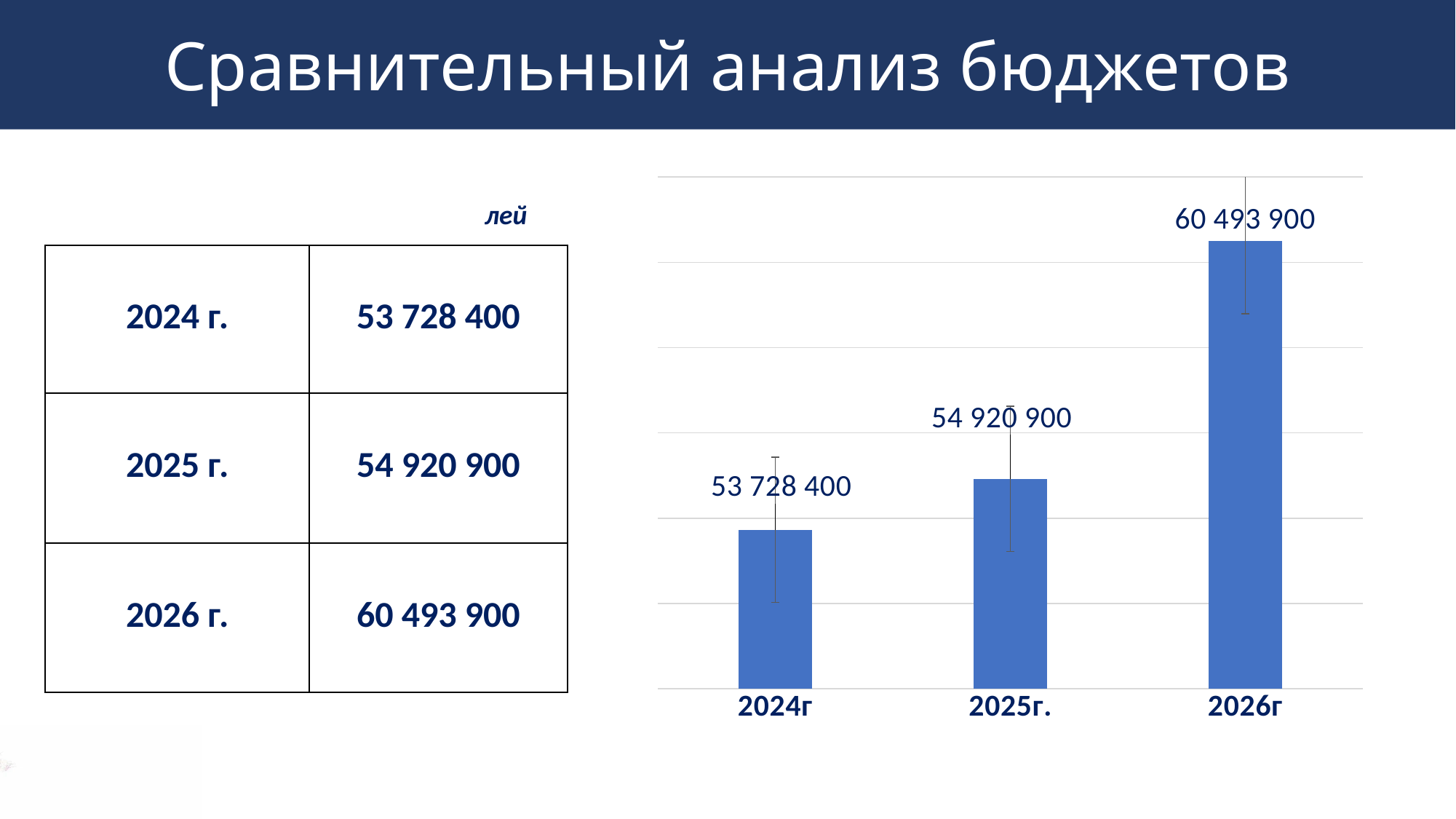
Which year has the lowest value in the bar chart? 2024г What is the difference between the values for 2026г and 2025г. in the bar chart? 5 573 000 What is the value shown for 2026г in the bar chart? 60 493 900 How many bars are shown in the bar chart? 3 What is the value shown for 2024г in the bar chart? 53 728 400 What is the difference between the values for 2025г. and 2024г in the bar chart? 1 192 500 What type of chart is shown on the slide? bar chart Which year has the highest value in the bar chart? 2026г What is the value shown for 2025г. in the bar chart? 54 920 900 Do the values in the bar chart rise or fall from 2024г to 2026г? rise Which is larger in the bar chart, the value for 2025г. or the value for 2026г? 2026г What is the difference between the values for 2026г and 2024г in the bar chart? 6 765 500